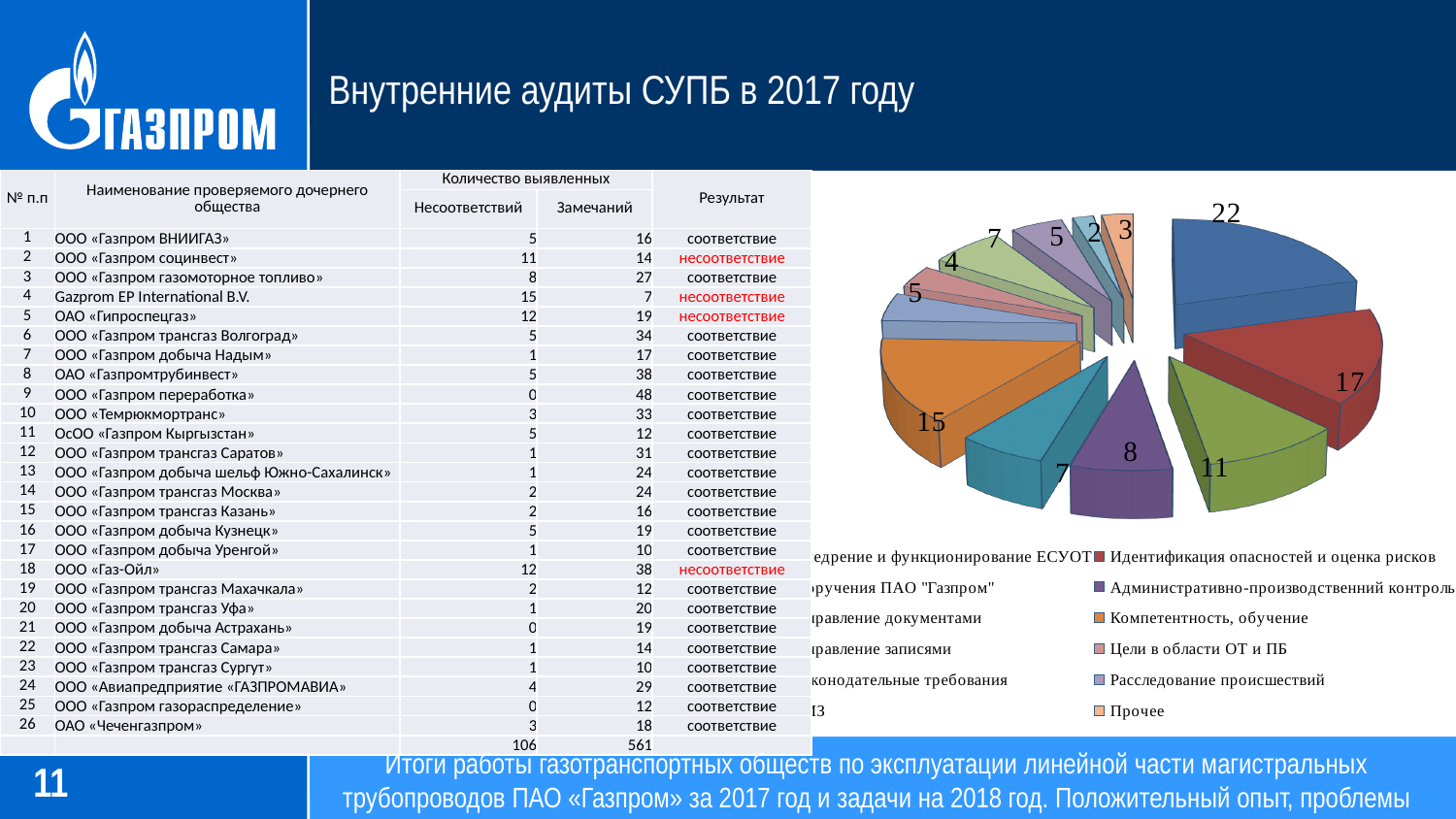
What is the largest value labelled on the pie chart? 22 Which is larger in the pie chart: the slice for "Компетентность, обучение" or the slice for "Идентификация опасностей и оценка рисков"? Идентификация опасностей и оценка рисков What is the sum of all slice values shown on the pie chart? 106 What is the value of the purple slice labelled "Административно-производственный контроль" in the pie chart? 8 What colour is the slice labelled "Компетентность, обучение" in the pie chart legend? orange What is the value of the orange slice labelled "Компетентность, обучение" in the pie chart? 15 Which legend entry of the pie chart is listed last? Прочее What is the smallest value labelled on the pie chart? 2 How many slices does the pie chart contain? 12 What kind of chart is shown on the right side of the slide? pie chart What is the value of the red slice labelled "Идентификация опасностей и оценка рисков" in the pie chart? 17 What is the difference between the largest slice (22) and the second largest slice (17) in the pie chart? 5